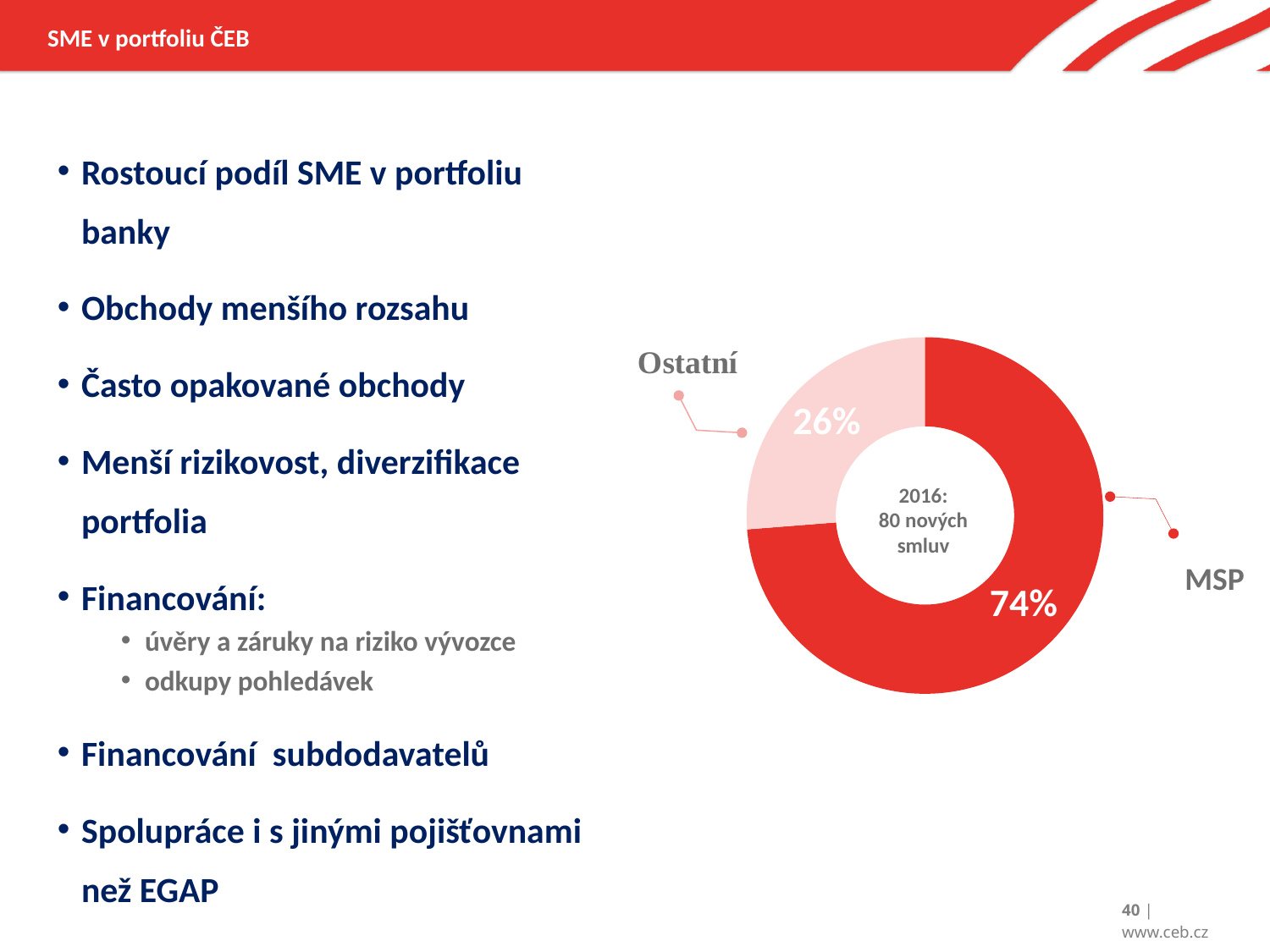
Which category has the smallest share in the doughnut chart? Ostatní What kind of chart is shown on the slide? Doughnut (pie) chart Which colour represents the MSP segment in the doughnut chart? Red Which category has the largest share in the doughnut chart? MSP Which is larger in the doughnut chart, the MSP share or the Ostatní share? MSP What text is shown in the centre of the doughnut chart? 2016: 80 nových smluv How many categories are shown in the doughnut chart? 2 What is the total of the two shares shown in the doughnut chart? 100% What is the difference in percentage points between the MSP share and the Ostatní share? 48 What share of the doughnut chart does Ostatní represent? 26% What share of the doughnut chart does MSP represent? 74%